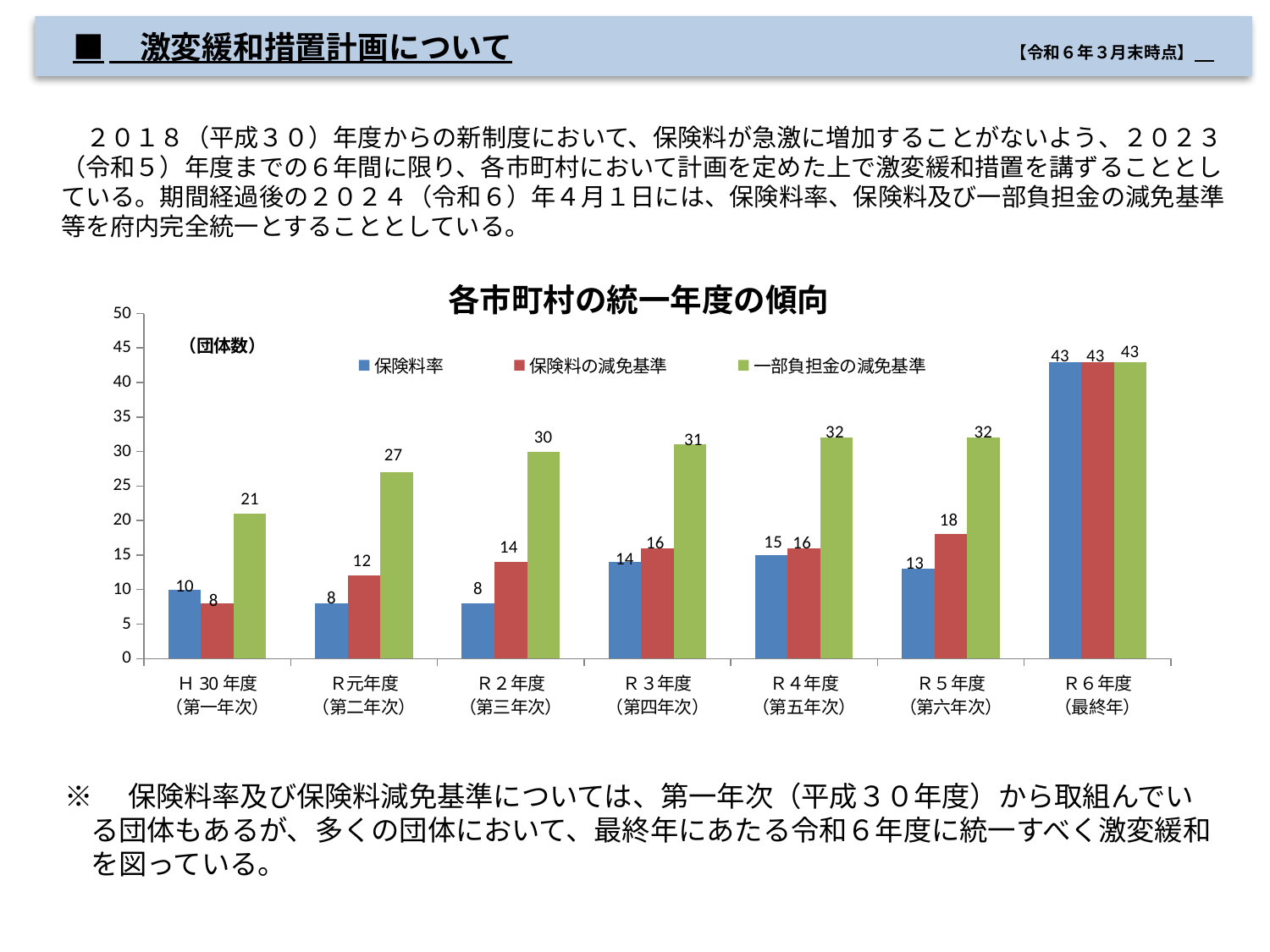
What kind of chart is this? Bar chart Which category has the lowest value for 保険料の減免基準? H30年度（第一年次） How many categories are shown on the x axis? 7 For R２年度（第三年次）, which is larger: 保険料の減免基準 or 保険料率? 保険料の減免基準 What is the difference between 一部負担金の減免基準 and 保険料率 for H30年度（第一年次）? 11 What is the value of 保険料の減免基準 for R５年度（第六年次）? 18 What is the value of 一部負担金の減免基準 for R元年度（第二年次）? 27 Does the value of 一部負担金の減免基準 generally rise or fall from H30年度 to R６年度? Rise What is the title of the chart? 各市町村の統一年度の傾向 How many series does the legend list? 3 What is the value of 保険料率 for R４年度（第五年次）? 15 Which category has the highest value for 保険料率? R６年度（最終年）